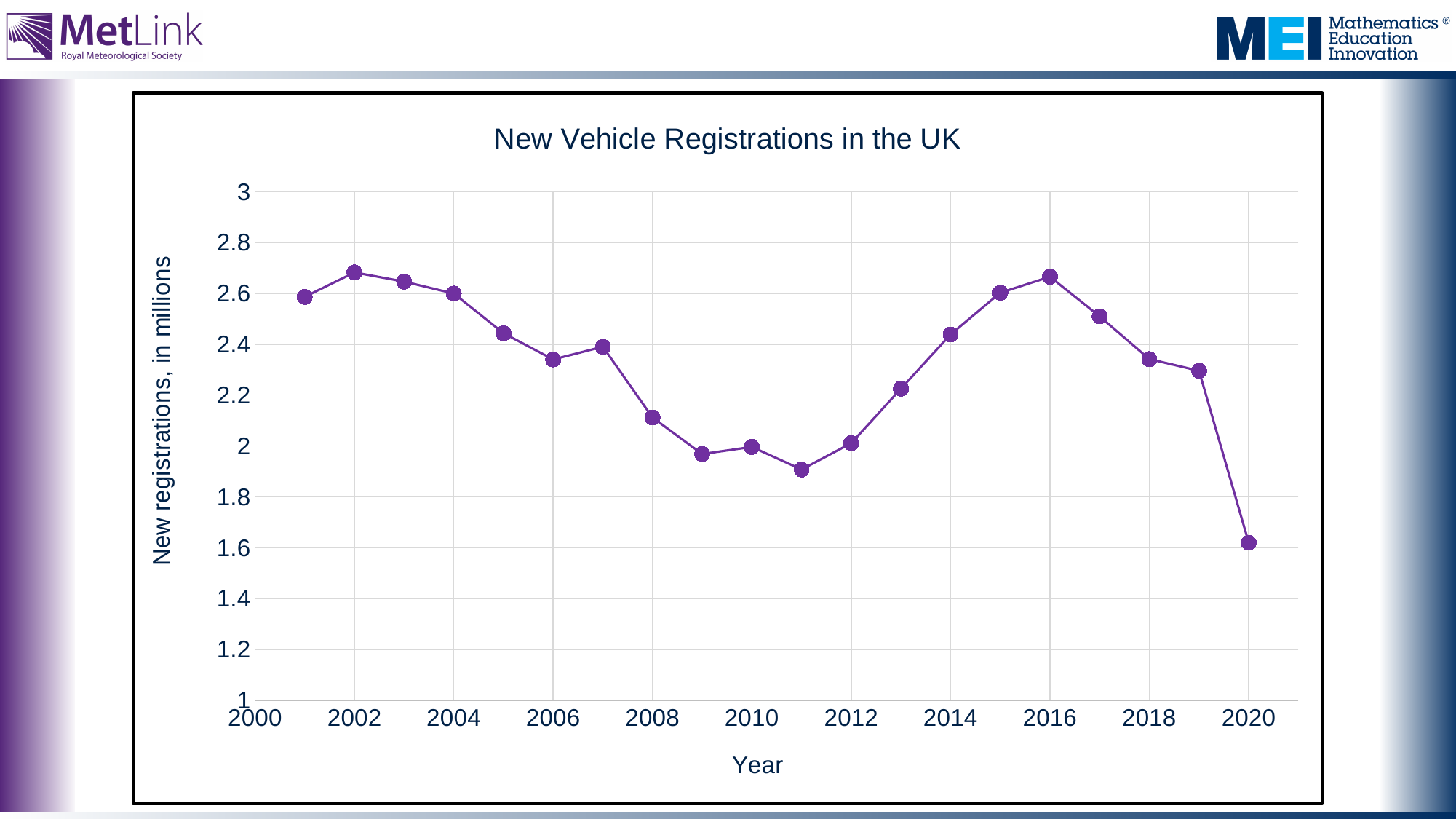
Is the value for 2011 greater or less than 2? less Is the value for 2016 greater or less than 2.6? greater Which year has more new vehicle registrations, 2004 or 2008? 2004 Do new vehicle registrations rise or fall between 2016 and 2020? fall Is the value for 2018 greater or less than 2.4? less Which year has the lowest number of new vehicle registrations? 2020 What kind of chart is shown on the slide? line chart Which year has more new vehicle registrations, 2009 or 2014? 2014 What is the label on the vertical axis of the chart? New registrations, in millions What is the title of the chart? New Vehicle Registrations in the UK How many data points are plotted on the chart? 20